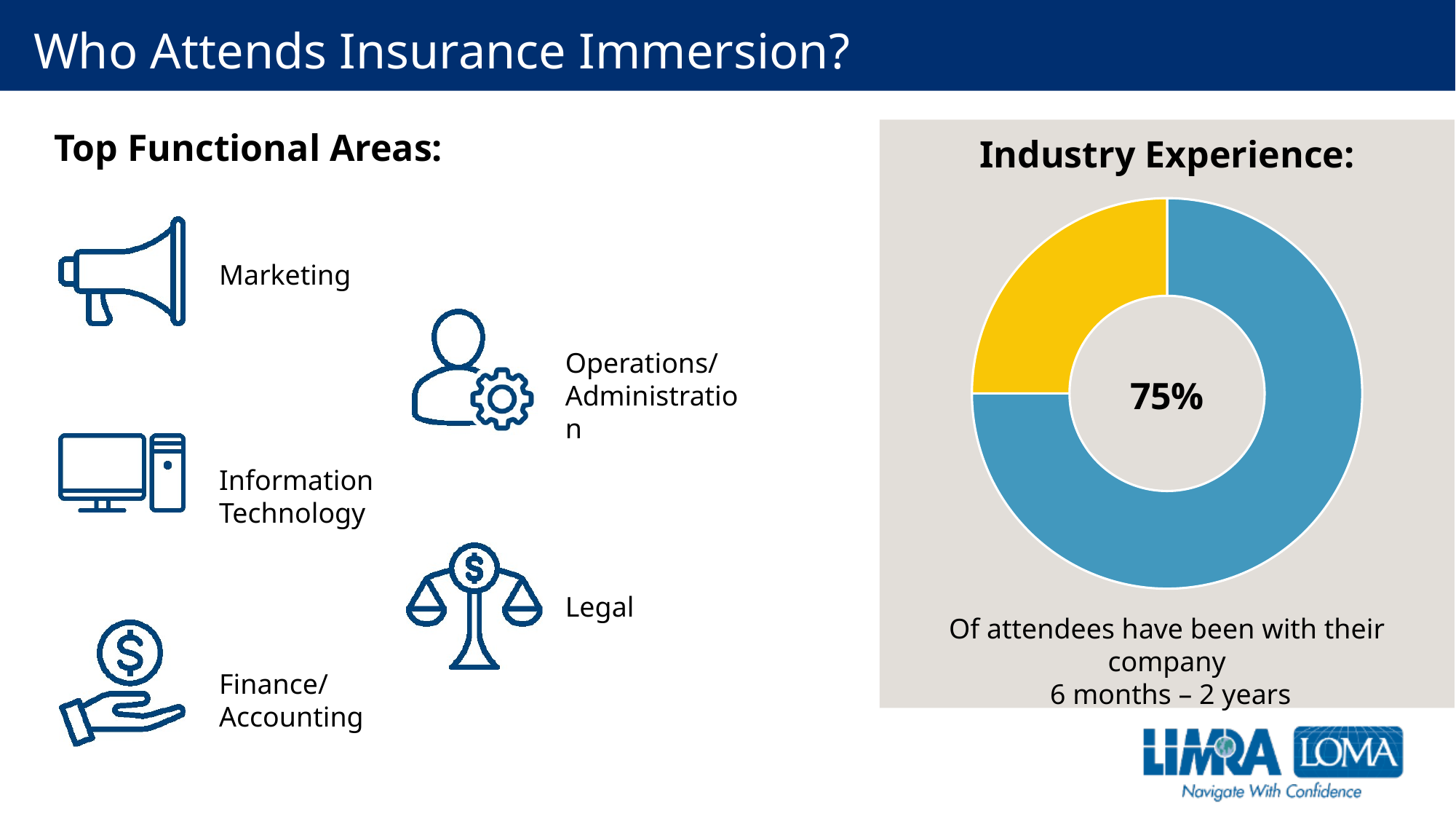
Does the blue slice of the Industry Experience donut chart cover more or less than half of the chart? more How many slices does the Industry Experience donut chart have? 2 What kind of chart is shown under the heading "Industry Experience:"? donut chart Which colour slice is the smallest in the Industry Experience donut chart? yellow Which colour slice is the largest in the Industry Experience donut chart? blue What share of the Industry Experience donut chart does the blue slice represent? 75% In the Industry Experience donut chart, which slice is larger, the blue one or the yellow one? blue What is the title shown above the donut chart on the right of the slide? Industry Experience: According to the text below the donut chart, what does the 75% figure describe? Attendees who have been with their company 6 months – 2 years What percentage is printed in the centre of the Industry Experience donut chart? 75%